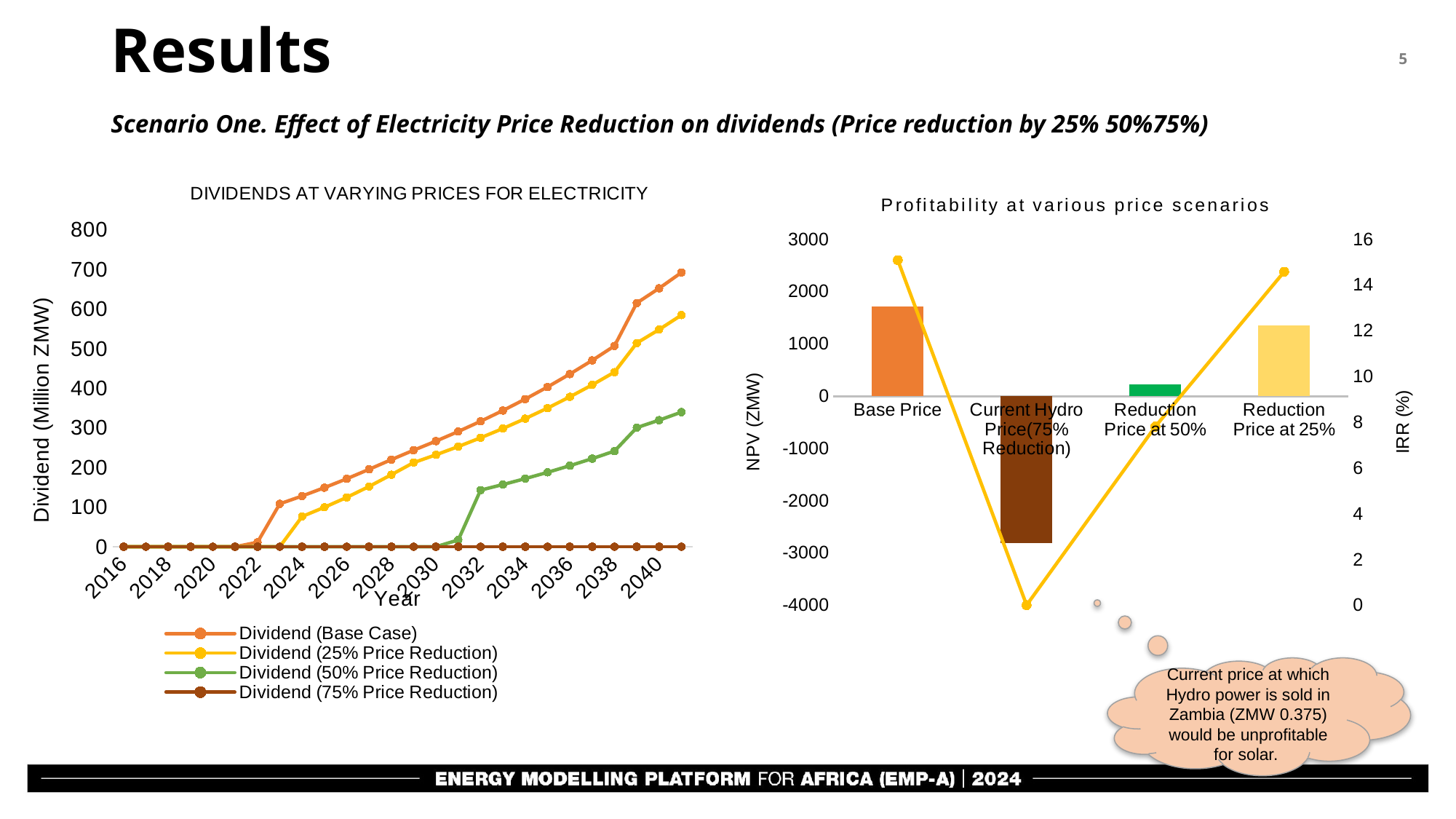
In the 'Profitability at various price scenarios' chart, is the NPV for Current Hydro Price(75% Reduction) greater or less than -2000? less In the 'Profitability at various price scenarios' chart, how many price scenarios are shown on the x axis? 4 In the 'Profitability at various price scenarios' chart, which has the larger NPV: Reduction Price at 50% or Reduction Price at 25%? Reduction Price at 25% What kind of chart is the 'DIVIDENDS AT VARYING PRICES FOR ELECTRICITY' chart? line chart In the 'DIVIDENDS AT VARYING PRICES FOR ELECTRICITY' chart, is the Dividend (Base Case) value in 2040 greater or less than 600? greater In the 'Profitability at various price scenarios' chart, which scenario has the lowest NPV? Current Hydro Price(75% Reduction) How many series does the legend of the 'DIVIDENDS AT VARYING PRICES FOR ELECTRICITY' chart list? 4 In the 'DIVIDENDS AT VARYING PRICES FOR ELECTRICITY' chart, does the Dividend (Base Case) series rise or fall from 2024 to 2040? rise In the 'DIVIDENDS AT VARYING PRICES FOR ELECTRICITY' chart, which series stays at 0 across all years? Dividend (75% Price Reduction) In the 'DIVIDENDS AT VARYING PRICES FOR ELECTRICITY' chart, which series has the highest dividend in 2040? Dividend (Base Case) In the 'Profitability at various price scenarios' chart, which scenario has the highest NPV? Base Price In the 'DIVIDENDS AT VARYING PRICES FOR ELECTRICITY' chart, is the Dividend (50% Price Reduction) value in 2040 greater or less than 300? greater